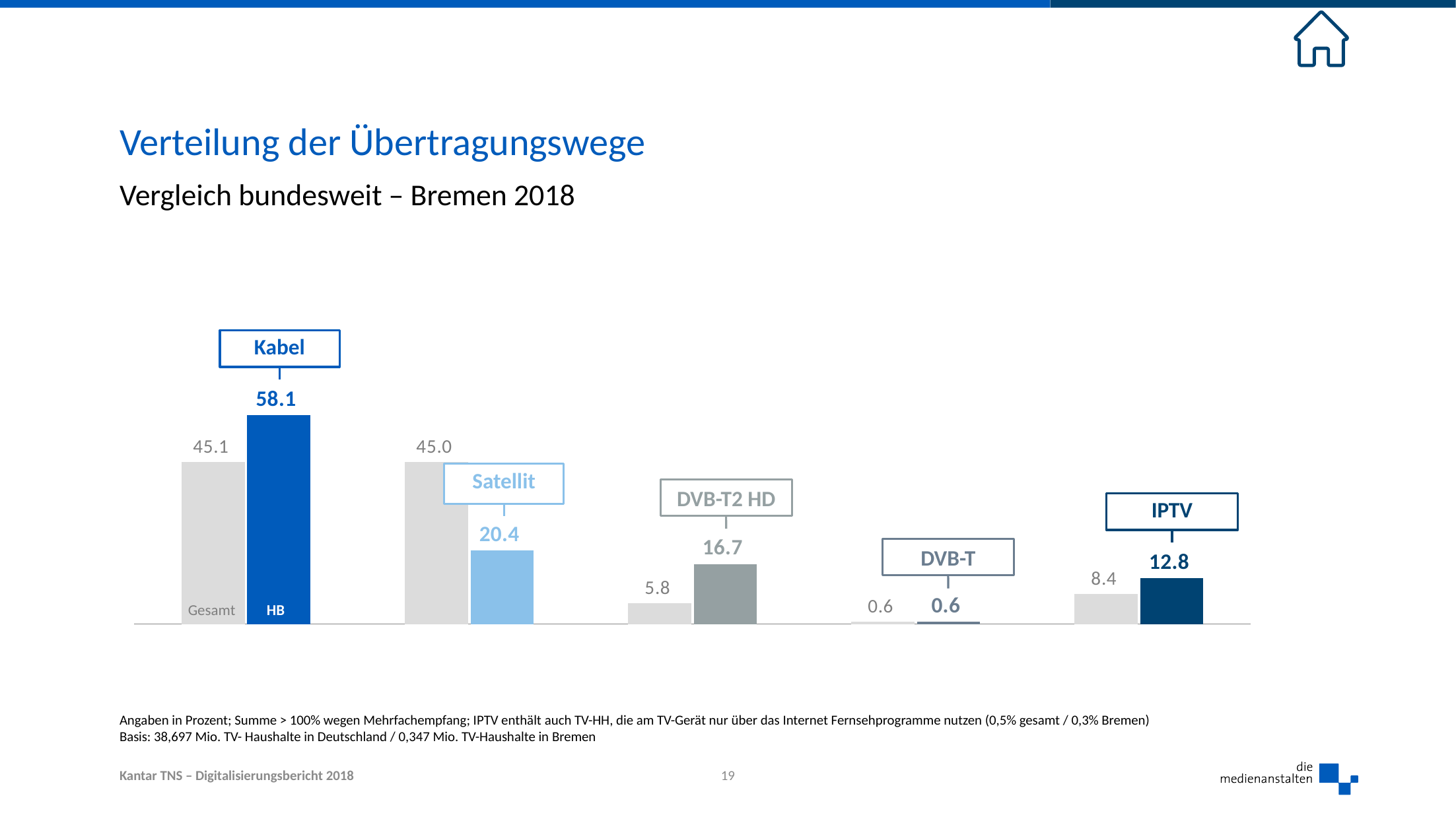
Which transmission path has the highest value for HB? Kabel What kind of chart is shown on the slide? Bar chart For IPTV, which is larger: the Gesamt value or the HB value? HB What is the Satellit value for Gesamt? 45.0 What is the Kabel value for HB (Bremen)? 58.1 What is the IPTV value for Gesamt? 8.4 What is the difference between the Gesamt and HB values for Satellit? 24.6 What is the title of the slide? Verteilung der Übertragungswege What is the DVB-T2 HD value for HB? 16.7 How many transmission paths are shown in the chart? 5 What is the difference between the HB and Gesamt values for Kabel? 13.0 Which transmission path has the lowest value for Gesamt? DVB-T